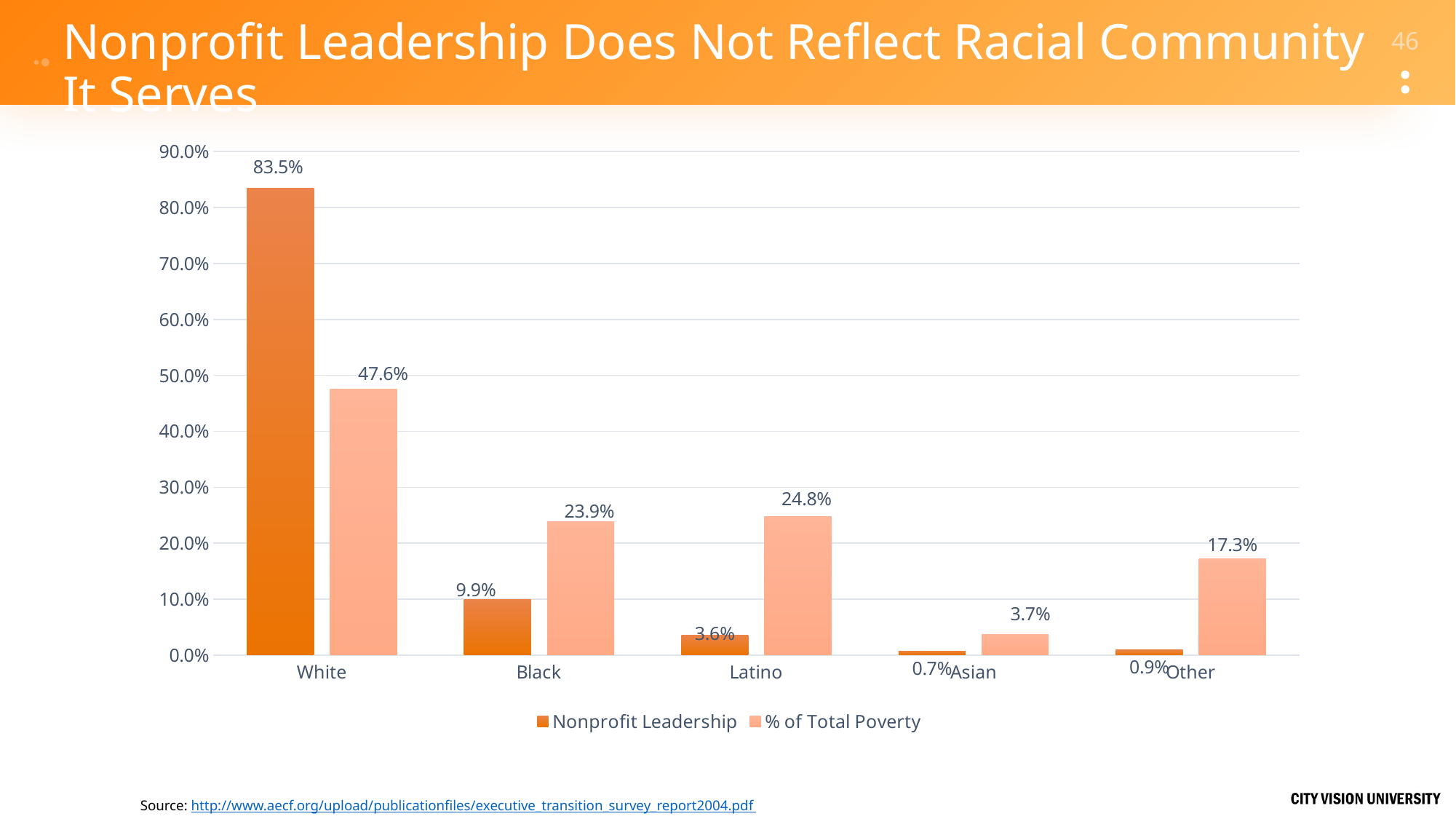
How many series does the legend list? 2 How many categories are shown on the x axis? 5 Is the % of Total Poverty value for Black greater or less than 20.0%? greater What kind of chart is shown on the slide? Bar chart What is the Nonprofit Leadership value for White? 83.5% Which category has the lowest Nonprofit Leadership value? Asian What is the difference between the Nonprofit Leadership and % of Total Poverty values for White? 35.9% What is the % of Total Poverty value for Other? 17.3% What is the % of Total Poverty value for Latino? 24.8% What is the Nonprofit Leadership value for Asian? 0.7% Which is larger for Black: Nonprofit Leadership or % of Total Poverty? % of Total Poverty Which category has the highest % of Total Poverty value? White